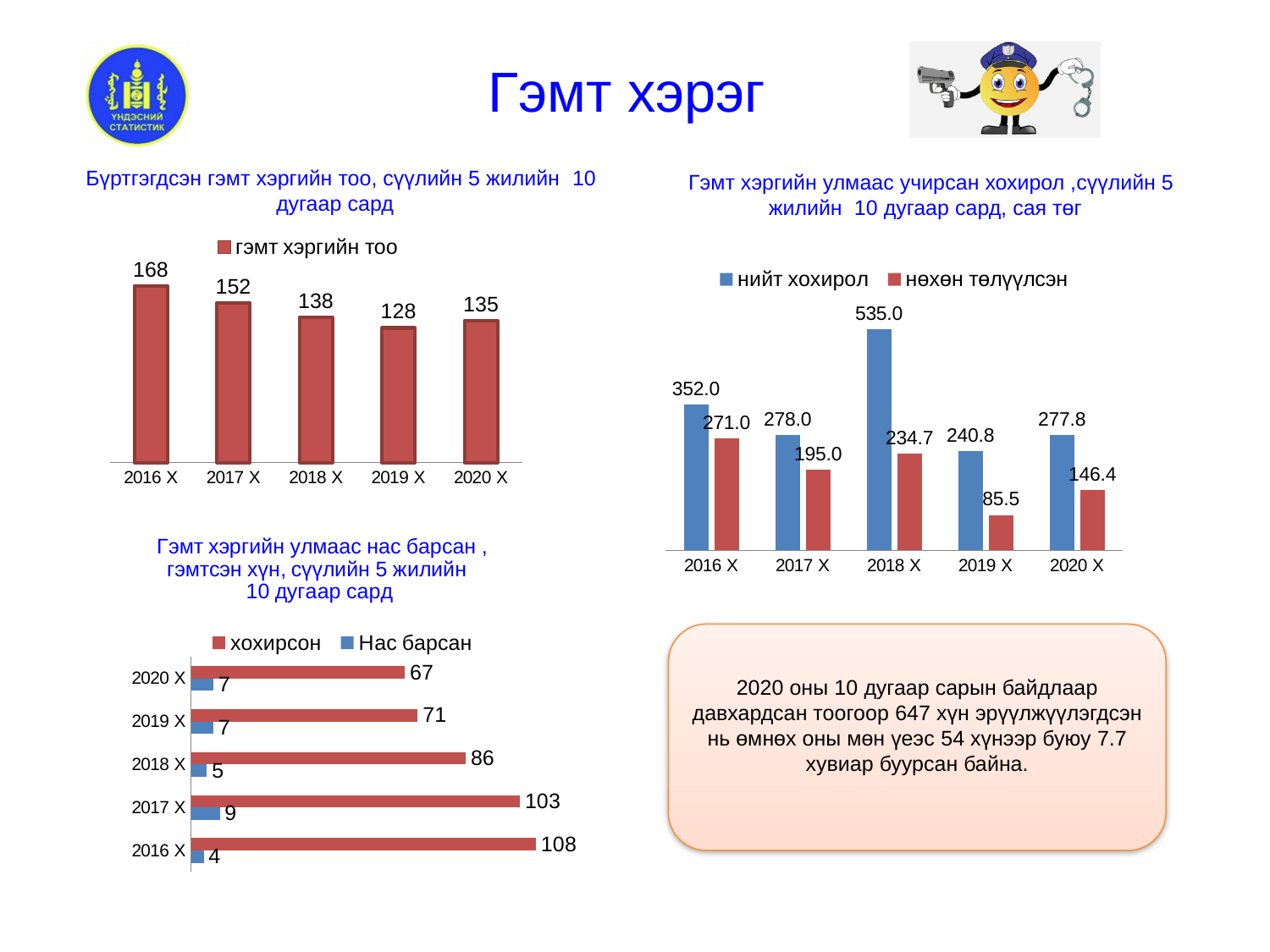
In the top-left chart (Бүртгэгдсэн гэмт хэргийн тоо), which year has the lowest value? 2019 X In the bottom-left chart (Гэмт хэргийн улмаас нас барсан, гэмтсэн хүн), which year has the highest Нас барсан value? 2017 X What type of chart is the bottom-left chart (Гэмт хэргийн улмаас нас барсан, гэмтсэн хүн)? Bar chart In the top-left chart (Бүртгэгдсэн гэмт хэргийн тоо), what is the value for 2016 X? 168 In the top-right chart (Гэмт хэргийн улмаас учирсан хохирол), what is the value of нөхөн төлүүлсэн for 2019 X? 85.5 In the top-right chart (Гэмт хэргийн улмаас учирсан хохирол), which year has the highest нийт хохирол value? 2018 X In the top-left chart (Бүртгэгдсэн гэмт хэргийн тоо), what is the difference between the values for 2016 X and 2020 X? 33 In the bottom-left chart (Гэмт хэргийн улмаас нас барсан, гэмтсэн хүн), what is the хохирсон value for 2017 X? 103 In the top-right chart (Гэмт хэргийн улмаас учирсан хохирол), what is the value of нийт хохирол for 2018 X? 535.0 In the top-right chart (Гэмт хэргийн улмаас учирсан хохирол), how many series does the legend list? 2 In the top-right chart (Гэмт хэргийн улмаас учирсан хохирол), what is the difference between нийт хохирол and нөхөн төлүүлсэн for 2020 X? 131.4 In the top-left chart (Бүртгэгдсэн гэмт хэргийн тоо), how many years are shown on the x axis? 5